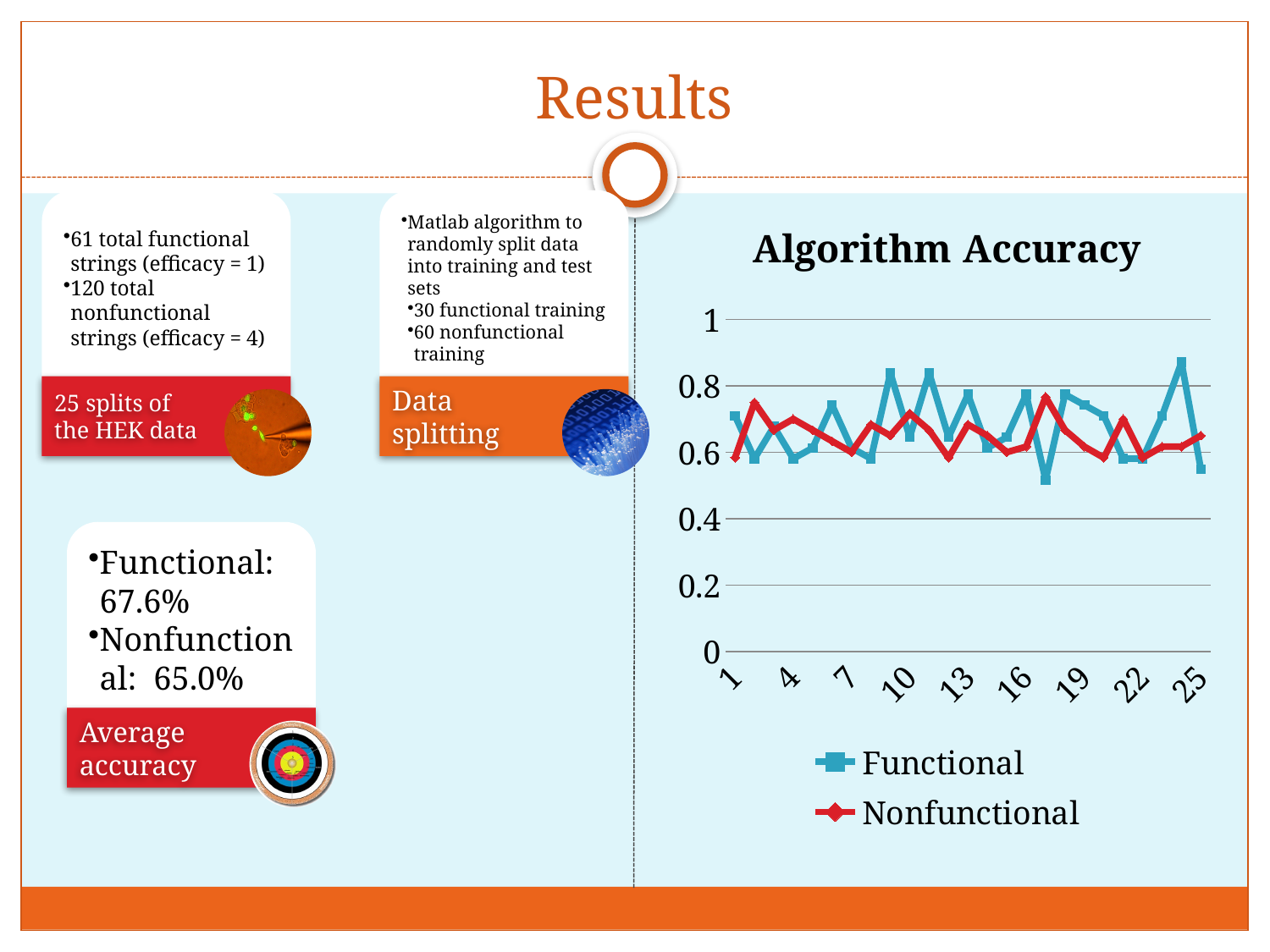
In the Algorithm Accuracy chart, is the Functional value at split 17 greater or less than 0.6? less What kind of chart is the Algorithm Accuracy chart? line chart How many series does the legend of the Algorithm Accuracy chart list? 2 In the Algorithm Accuracy chart, is the Functional value at split 25 greater or less than 0.6? less Which two series are listed in the legend of the Algorithm Accuracy chart? Functional and Nonfunctional How many points along the x axis does each series in the Algorithm Accuracy chart have? 25 In the Algorithm Accuracy chart, which series has the larger value at split 17, Functional or Nonfunctional? Nonfunctional In the Algorithm Accuracy chart, is the Functional value at split 24 greater or less than 0.8? greater In the Algorithm Accuracy chart, which series has the larger value at split 24, Functional or Nonfunctional? Functional In the Algorithm Accuracy chart, which series reaches the highest value anywhere on the chart? Functional What is the title of the chart on the slide? Algorithm Accuracy